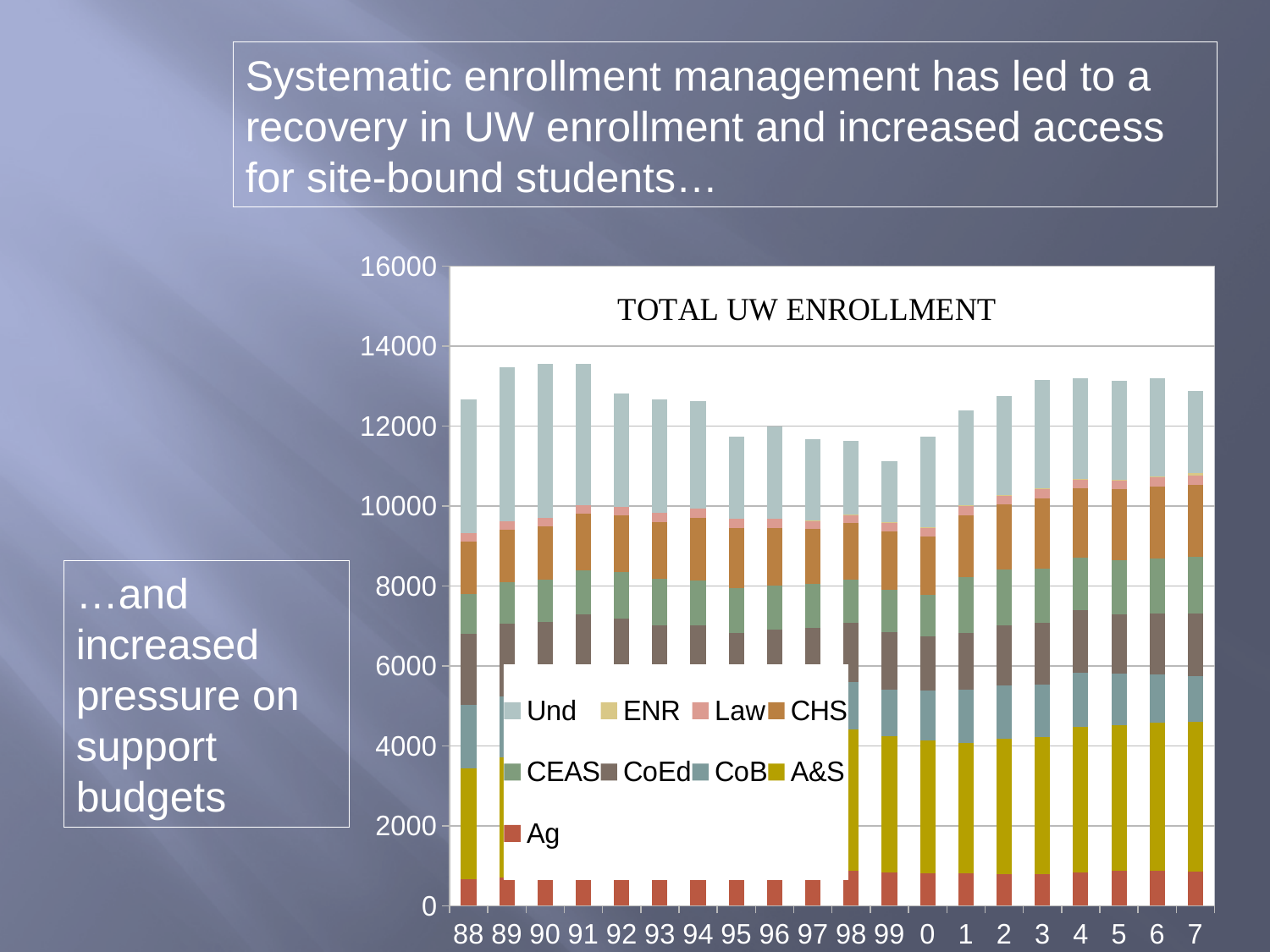
Which has the larger total enrollment, 99 or 3? 3 How many series does the chart's legend list? 9 Which series forms the bottom segment of each stacked bar? Ag Is the total enrollment for 99 greater or less than 12000? less What kind of chart is shown on the slide? Stacked bar chart Which has the larger total enrollment, 88 or 99? 88 What is the title of the chart? TOTAL UW ENROLLMENT How many years (bars) are shown along the x axis? 20 Does total enrollment rise or fall from 99 to 3? rise Is the total enrollment for 3 greater or less than 12000? greater Is the total enrollment for 90 greater or less than 12000? greater Which year has the lowest total enrollment? 99